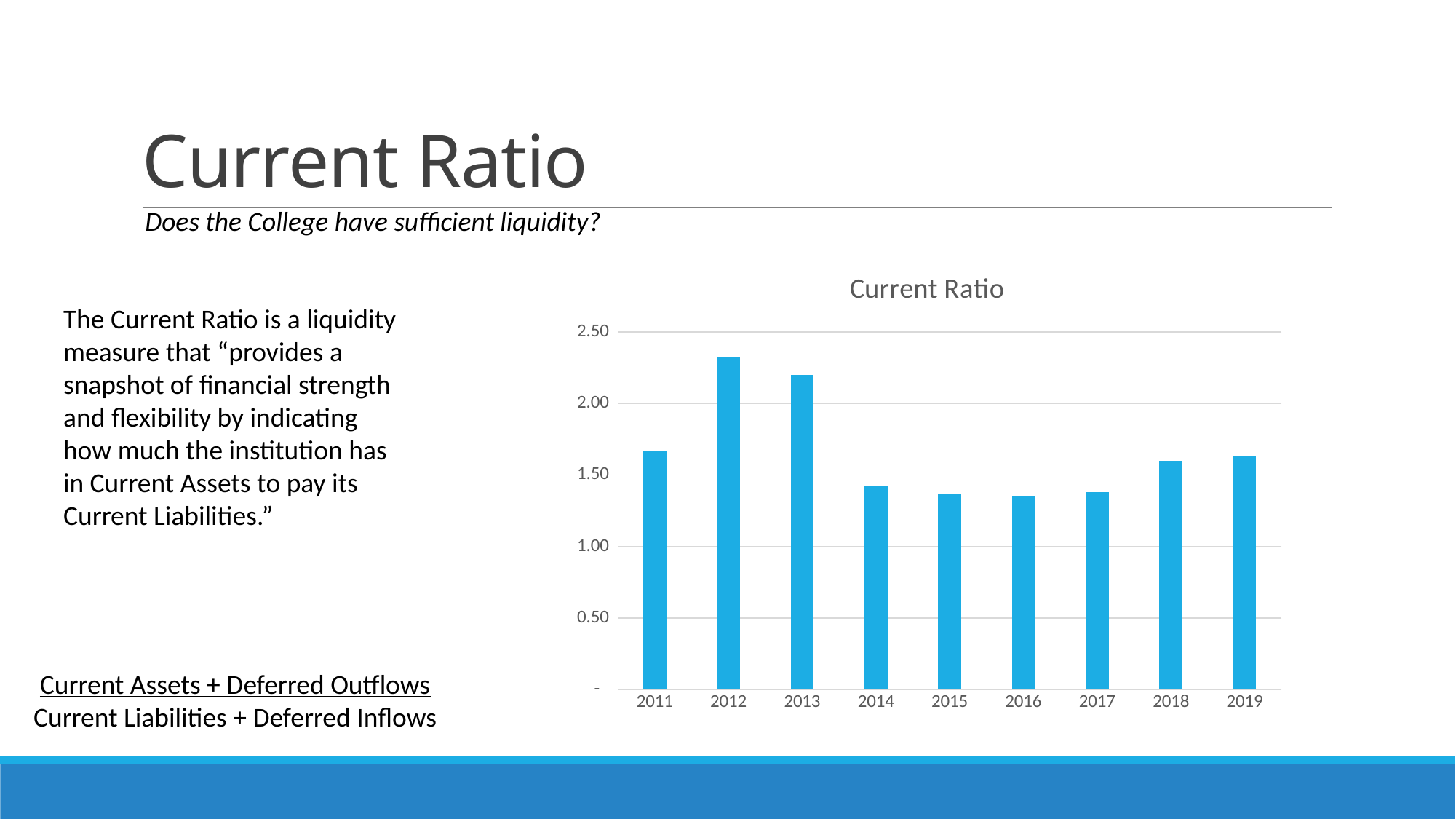
Is the current ratio for 2013 greater or less than 2.00? greater What is the title of the chart? Current Ratio How many years are shown on the x axis of the chart? 9 Which year has the highest current ratio? 2012 Does the current ratio rise or fall from 2012 to 2014? fall Is the current ratio for 2011 greater or less than 1.50? greater Which year has the larger current ratio, 2011 or 2014? 2011 Is the current ratio for 2012 greater or less than 2.00? greater What kind of chart is shown on the slide? bar chart